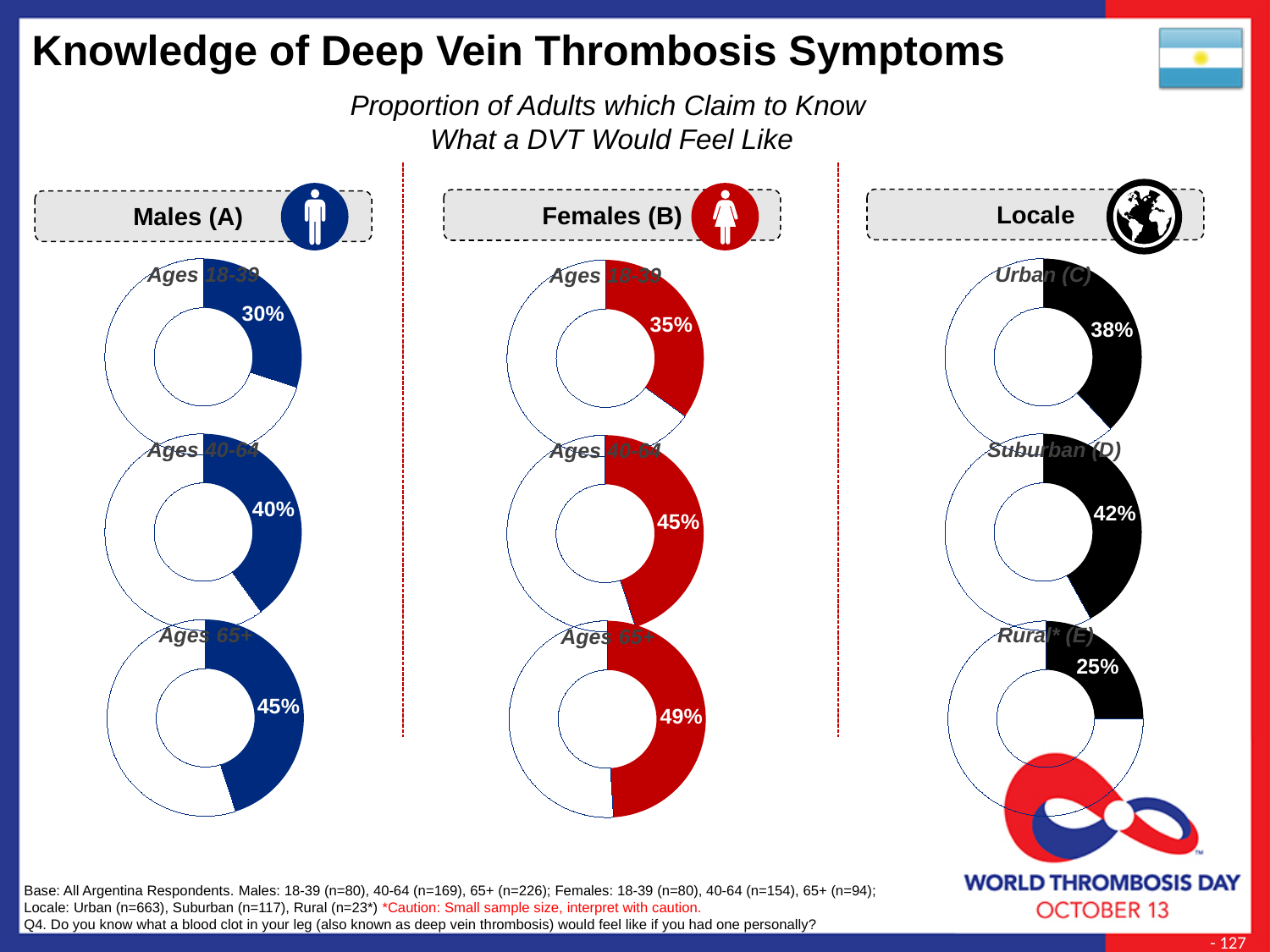
In the Females (B) column, what value is shown for Ages 65+? 49% What is the difference between the Females (B) Ages 40-64 value and the Males (A) Ages 40-64 value? 5% In the Locale column, what value is shown for Suburban (D)? 42% In the Males (A) column, do the values rise or fall as age increases from 18-39 to 65+? rise What colour are the filled segments of the Females (B) donut charts? Red Among the three Females (B) donut charts, which age group has the highest value? Ages 65+ Which is larger: the Males (A) Ages 65+ value or the Locale Urban (C) value? Males (A) Ages 65+ In the Locale column, what value is shown for Rural* (E)? 25% Among the three Locale donut charts, which locale has the lowest value? Rural* (E) In the Males (A) column, what proportion of adults aged 18-39 claim to know what a DVT would feel like? 30% How many donut charts are shown in the Locale column? 3 What type of chart is used to show the Males (A) Ages 18-39 value? Donut (pie) chart